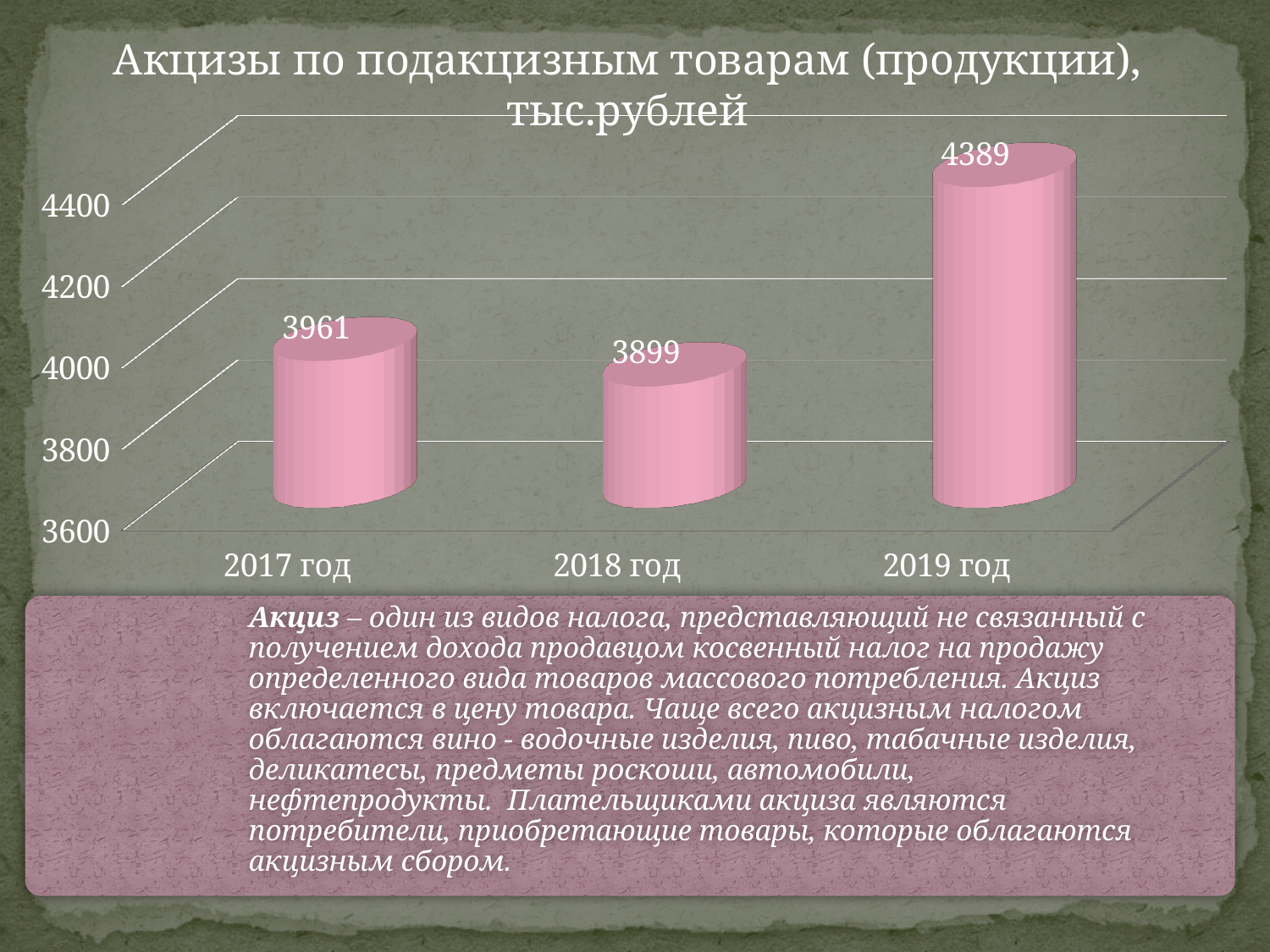
Which year has the highest value? 2019 год How many categories are shown on the x axis? 3 What is the value for 2018 год? 3899 What is the difference between the values for 2017 год and 2018 год? 62 What is the value for 2019 год? 4389 What kind of chart is shown on the slide? bar chart Which year has the lowest value? 2018 год Is the value for 2019 год greater or less than 4200? greater What is the value for 2017 год? 3961 What is the title of the chart? Акцизы по подакцизным товарам (продукции), тыс.рублей Which is larger, the value for 2017 год or the value for 2018 год? 2017 год What is the difference between the values for 2019 год and 2018 год? 490